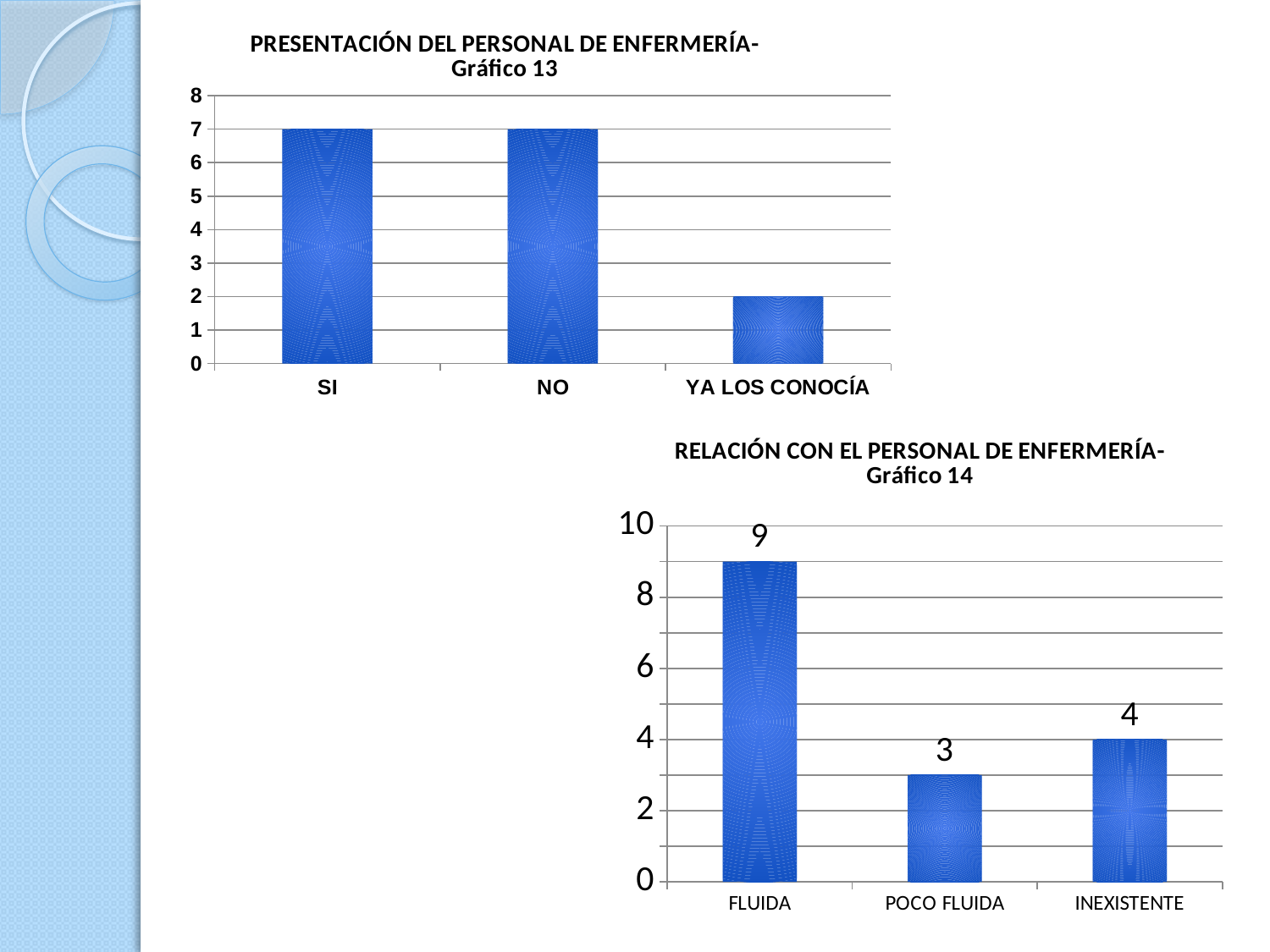
In the chart titled 'RELACIÓN CON EL PERSONAL DE ENFERMERÍA- Gráfico 14', what is the value for POCO FLUIDA? 3 In the chart titled 'RELACIÓN CON EL PERSONAL DE ENFERMERÍA- Gráfico 14', which category has the highest value? FLUIDA In the chart titled 'PRESENTACIÓN DEL PERSONAL DE ENFERMERÍA- Gráfico 13', how many categories are shown? 3 In the chart titled 'PRESENTACIÓN DEL PERSONAL DE ENFERMERÍA- Gráfico 13', what is the value for SI? 7 In the chart titled 'PRESENTACIÓN DEL PERSONAL DE ENFERMERÍA- Gráfico 13', which category has the lowest value? YA LOS CONOCÍA What kind of chart is the one titled 'RELACIÓN CON EL PERSONAL DE ENFERMERÍA- Gráfico 14'? Bar chart In the chart titled 'PRESENTACIÓN DEL PERSONAL DE ENFERMERÍA- Gráfico 13', is the value for NO greater or less than 5? greater In the chart titled 'PRESENTACIÓN DEL PERSONAL DE ENFERMERÍA- Gráfico 13', what is the value for YA LOS CONOCÍA? 2 In the chart titled 'RELACIÓN CON EL PERSONAL DE ENFERMERÍA- Gráfico 14', what is the difference between the values for FLUIDA and INEXISTENTE? 5 In the chart titled 'RELACIÓN CON EL PERSONAL DE ENFERMERÍA- Gráfico 14', which is larger, INEXISTENTE or POCO FLUIDA? INEXISTENTE In the chart titled 'PRESENTACIÓN DEL PERSONAL DE ENFERMERÍA- Gráfico 13', what is the difference between the values for NO and YA LOS CONOCÍA? 5 In the chart titled 'RELACIÓN CON EL PERSONAL DE ENFERMERÍA- Gráfico 14', what is the value for FLUIDA? 9